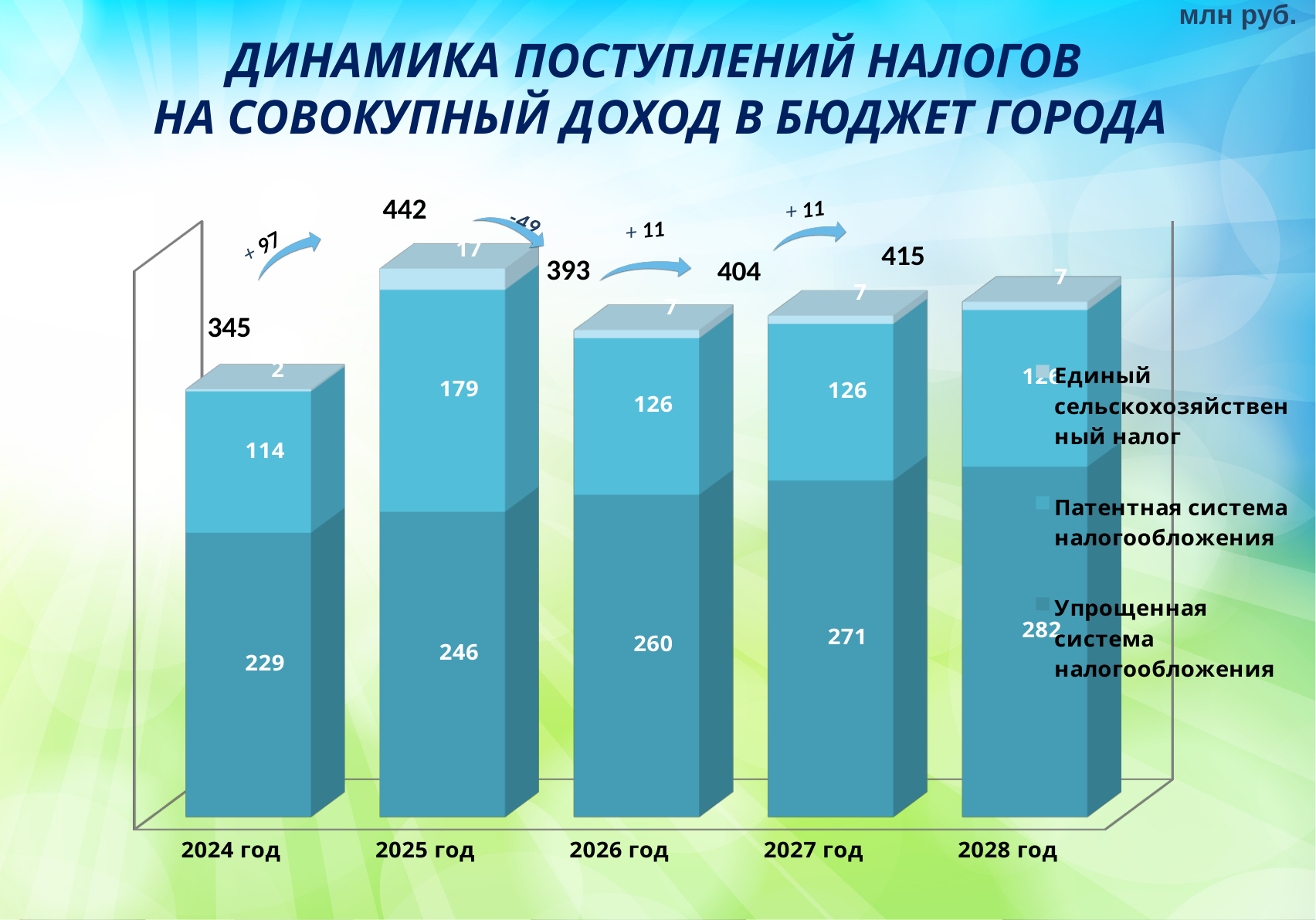
How many series does the legend list? 3 What type of chart is shown on the slide? bar chart What is the value of Упрощенная система налогообложения for 2024 год? 229 Which year has the highest total tax receipts? 2025 год What is the total shown above the stacked bar for 2025 год? 442 What unit is indicated in the top right corner of the slide? млн руб. How many years are shown on the x axis of the chart? 5 What is the value of Патентная система налогообложения for 2025 год? 179 What is the difference between the totals for 2025 год and 2026 год? 49 Which year has the lowest total tax receipts? 2024 год Which is larger: Упрощенная система налогообложения in 2027 год or in 2026 год? 2027 год What is the value of Единый сельскохозяйственный налог for 2026 год? 7